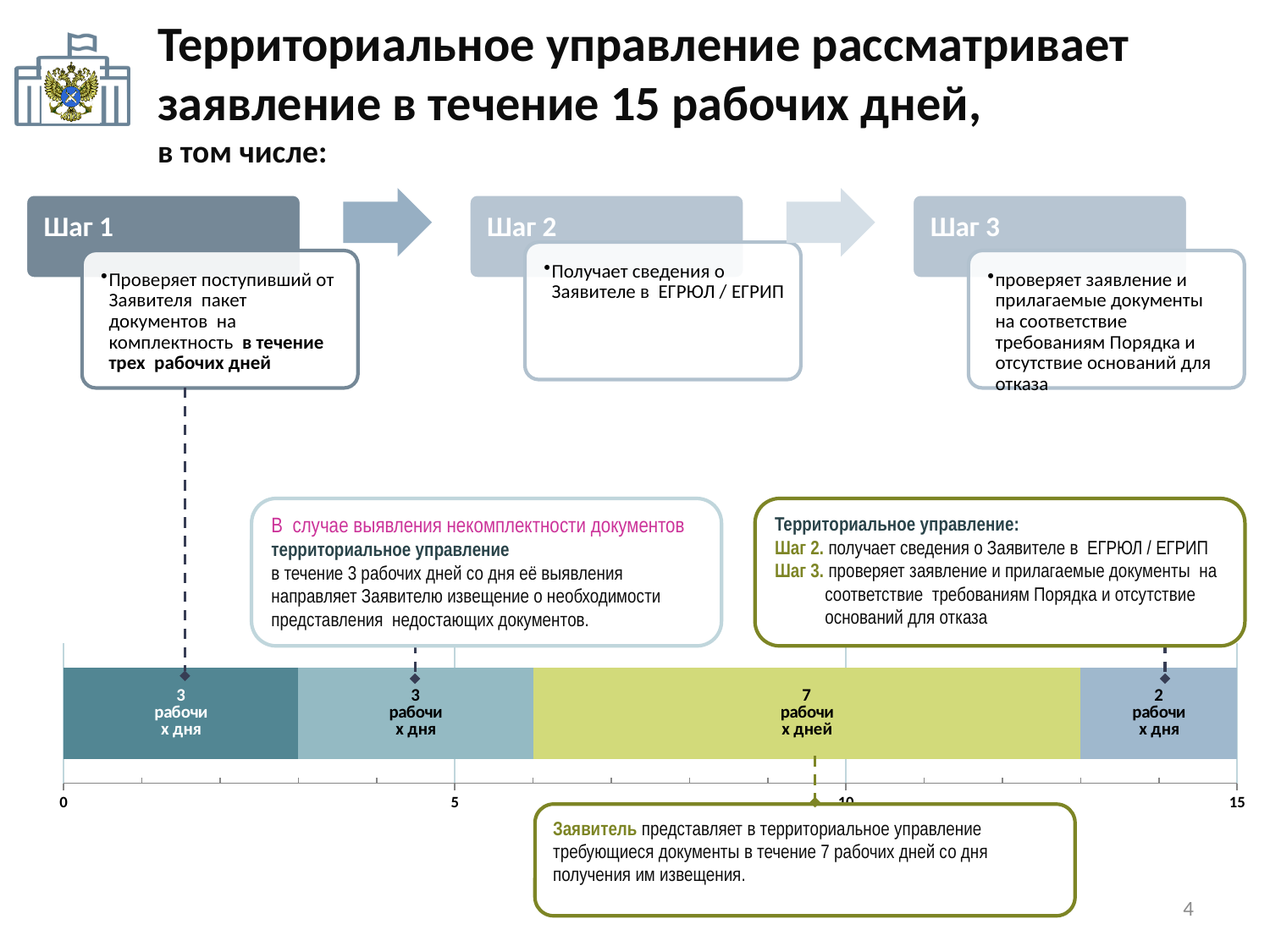
How many working days does the last (grey-blue) segment of the bar represent? 2 рабочих дня How many working days does the third (yellow-green) segment of the bar represent? 7 рабочих дней What is the difference in working days between the third segment and the last segment? 5 What is the maximum value shown on the horizontal axis of the timeline? 15 How many working days does the first (dark teal) segment of the bar represent? 3 рабочих дня Which segment of the stacked bar is the longest? the third (yellow-green) segment, 7 рабочих дней Which segment of the stacked bar is the shortest? the last (grey-blue) segment, 2 рабочих дня What is the total number of working days across all segments of the bar? 15 What kind of chart is shown at the bottom of the slide? bar chart How many segments make up the stacked bar on the timeline? 4 Which is larger: the first segment or the last segment of the bar? the first segment Is the value of the third segment greater or less than 5? greater